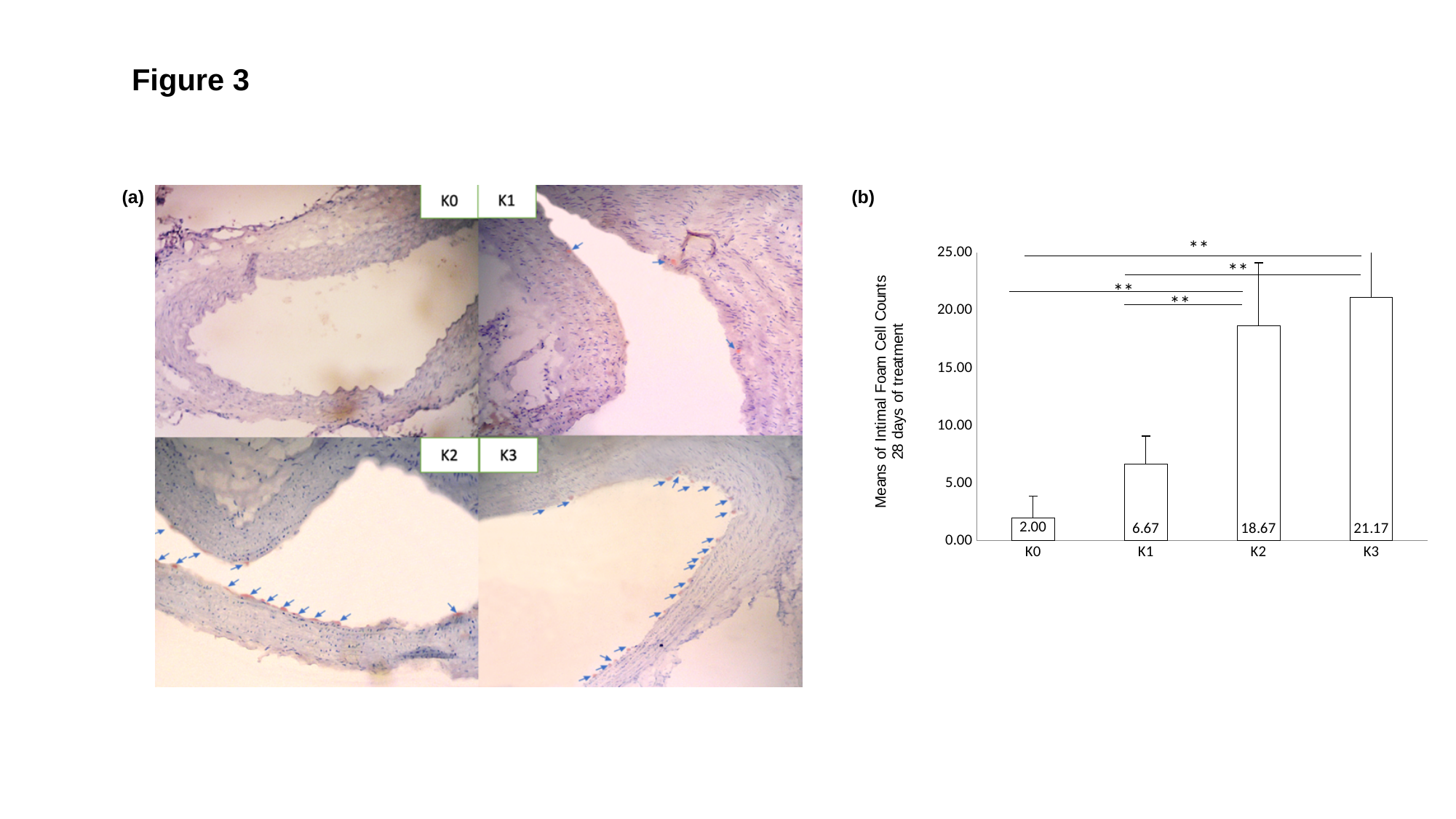
In the bar chart (b), what is the difference between the values for K2 and K1? 12.00 What kind of chart is panel (b)? Bar chart In the bar chart (b), which group has the lowest mean intimal foam cell count? K0 In the bar chart (b), do the values rise or fall from K0 to K3? Rise In the bar chart (b), what is the value for K0? 2.00 In the bar chart (b), what is the value for K3? 21.17 In the bar chart (b), how many groups are shown on the x axis? 4 In the bar chart (b), which group has the highest mean intimal foam cell count? K3 In the bar chart (b), what is the difference between the values for K3 and K2? 2.50 In the bar chart (b), what is the value for K2? 18.67 In the bar chart (b), what is the value for K1? 6.67 In the bar chart (b), which is larger, the value for K1 or the value for K2? K2